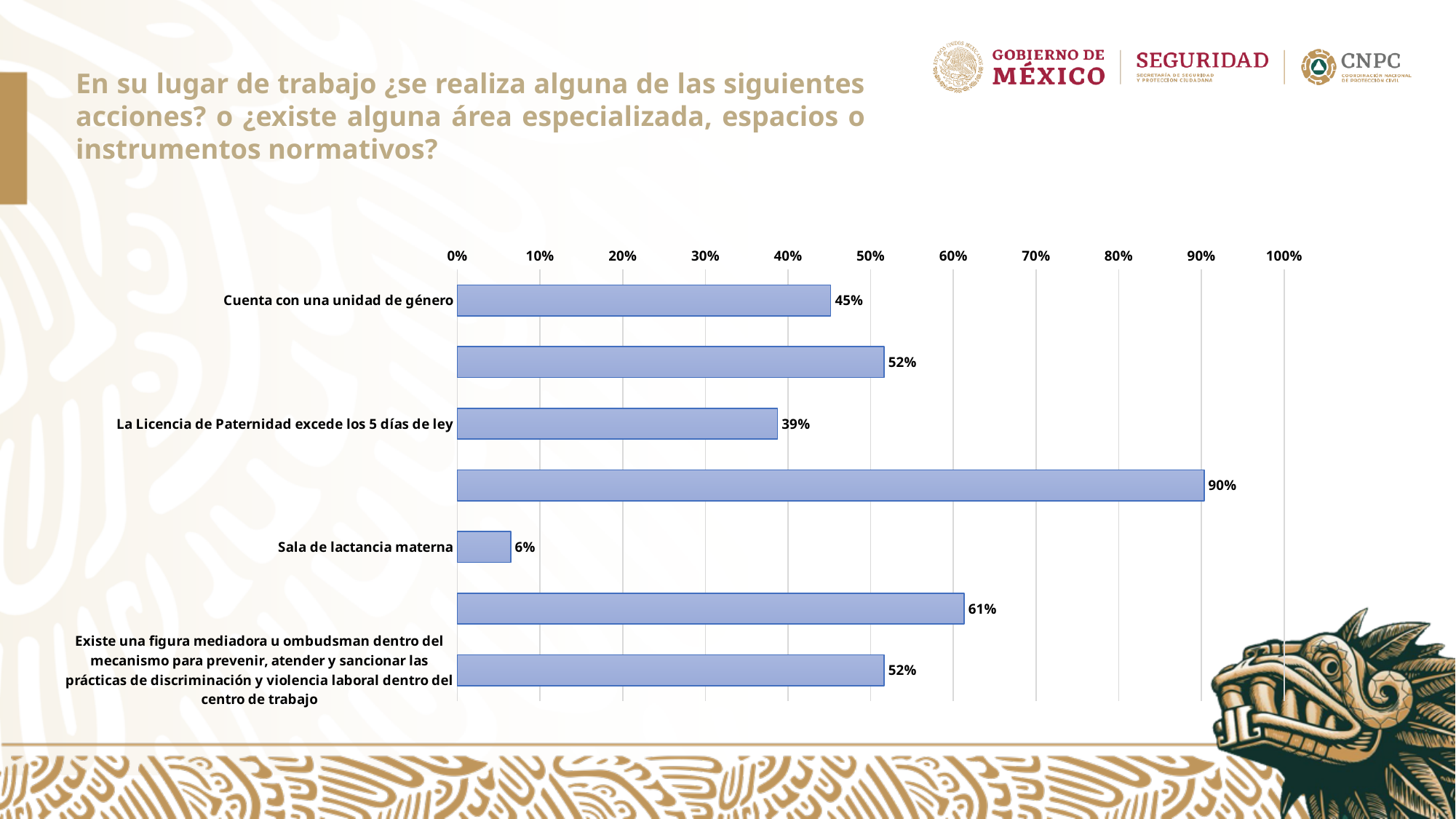
What is the difference between the values for "Existe una figura mediadora u ombudsman..." and "Sala de lactancia materna"? 46% Which category has the lowest value? Sala de lactancia materna What is the value for "La Licencia de Paternidad excede los 5 días de ley"? 39% What is the value for "Existe una figura mediadora u ombudsman dentro del mecanismo para prevenir, atender y sancionar las prácticas de discriminación y violencia laboral dentro del centro de trabajo"? 52% What kind of chart is shown on the slide? bar chart Is the value for "Sala de lactancia materna" greater or less than 10%? less What is the value for "Cuenta con una unidad de género"? 45% What is the difference between the values for "Cuenta con una unidad de género" and "La Licencia de Paternidad excede los 5 días de ley"? 6% What is the value for "Sala de lactancia materna"? 6% What is the highest value printed on the x axis? 100% How many bars are plotted in the chart? 7 Which is larger, the value for "Cuenta con una unidad de género" or the value for "La Licencia de Paternidad excede los 5 días de ley"? Cuenta con una unidad de género